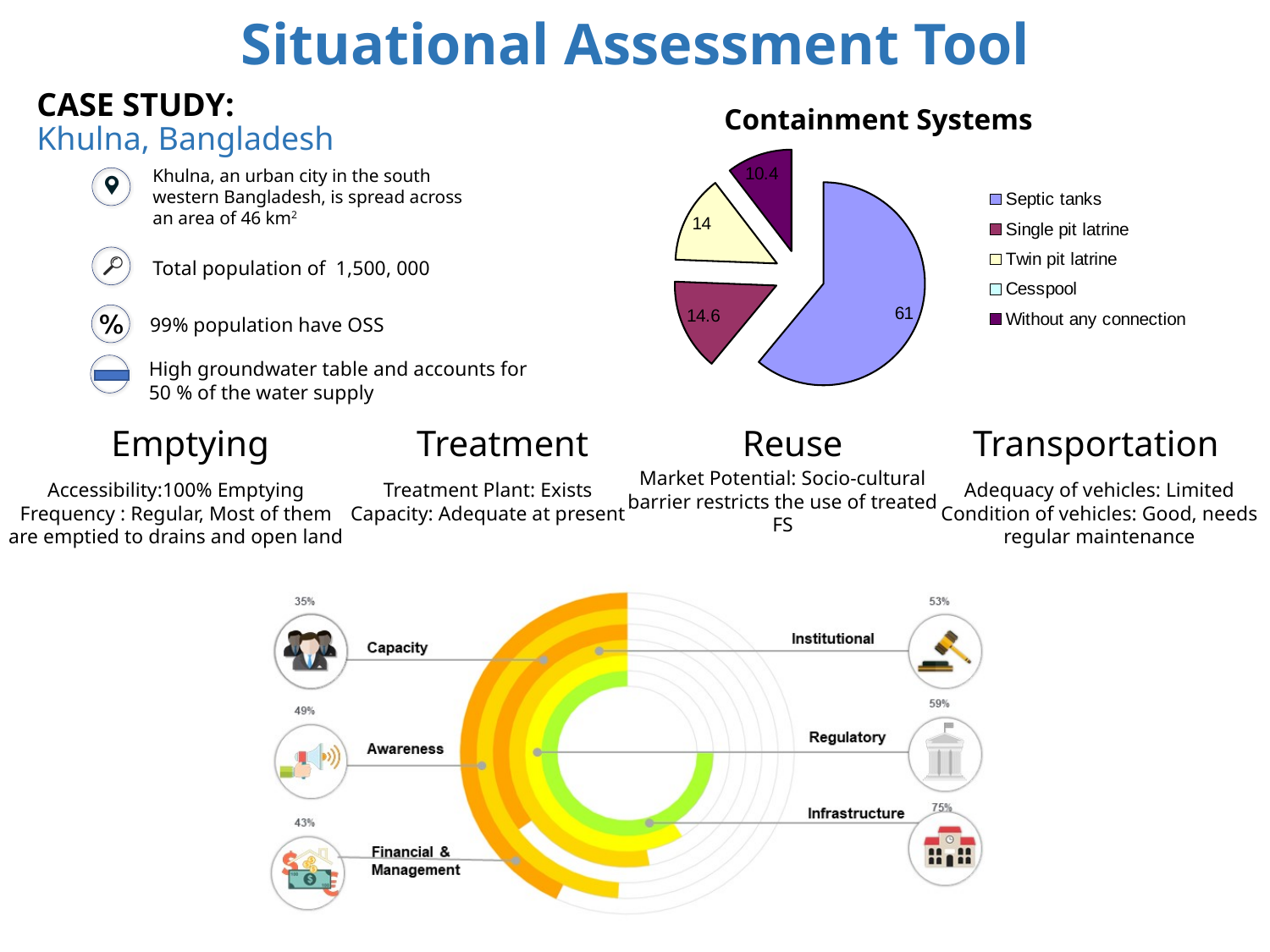
What type of chart is the Containment Systems chart? Pie chart In the Containment Systems pie chart, what is the difference between the Septic tanks value and the Single pit latrine value? 46.4 In the Containment Systems pie chart, which category has the largest slice? Septic tanks How many entries does the legend of the Containment Systems chart list? 5 In the Containment Systems pie chart, what value is shown for Septic tanks? 61 How many categories are shown in the radial chart at the bottom of the slide? 6 In the radial chart at the bottom of the slide, what percentage is shown for Infrastructure? 75% In the Containment Systems pie chart, which is larger: Single pit latrine or Twin pit latrine? Single pit latrine In the radial chart at the bottom of the slide, which category has the lowest percentage? Capacity In the Containment Systems pie chart, which labelled slice is the smallest? Without any connection In the Containment Systems pie chart, what value is shown for Without any connection? 10.4 In the Containment Systems pie chart, what value is shown for Single pit latrine? 14.6